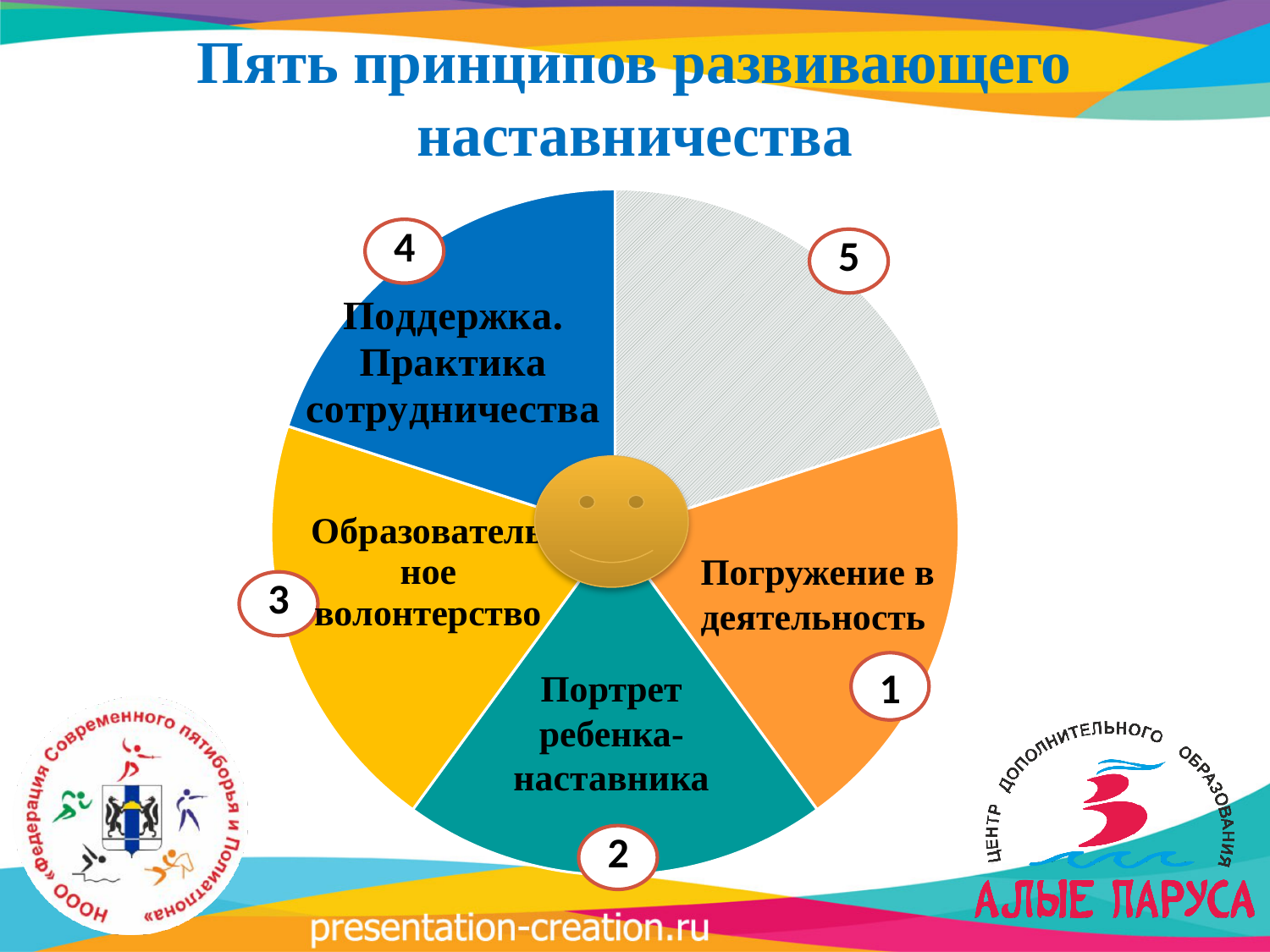
Which slice of the pie chart is numbered 2? Портрет ребенка-наставника What number is shown on the slice labelled 'Портрет ребенка-наставника'? 2 What is the title of the slide above the pie chart? Пять принципов развивающего наставничества Which slice of the pie chart is numbered 1? Погружение в деятельность Which slice of the pie chart is numbered 4? Поддержка. Практика сотрудничества Which slice of the pie chart is numbered 3? Образовательное волонтерство How many slices of the pie chart have a text label inside them? 4 What kind of chart is shown on the slide? pie chart Does the slice numbered 5 have a text label inside it? No What colour is the slice labelled 'Погружение в деятельность'? orange How many slices does the pie chart have? 5